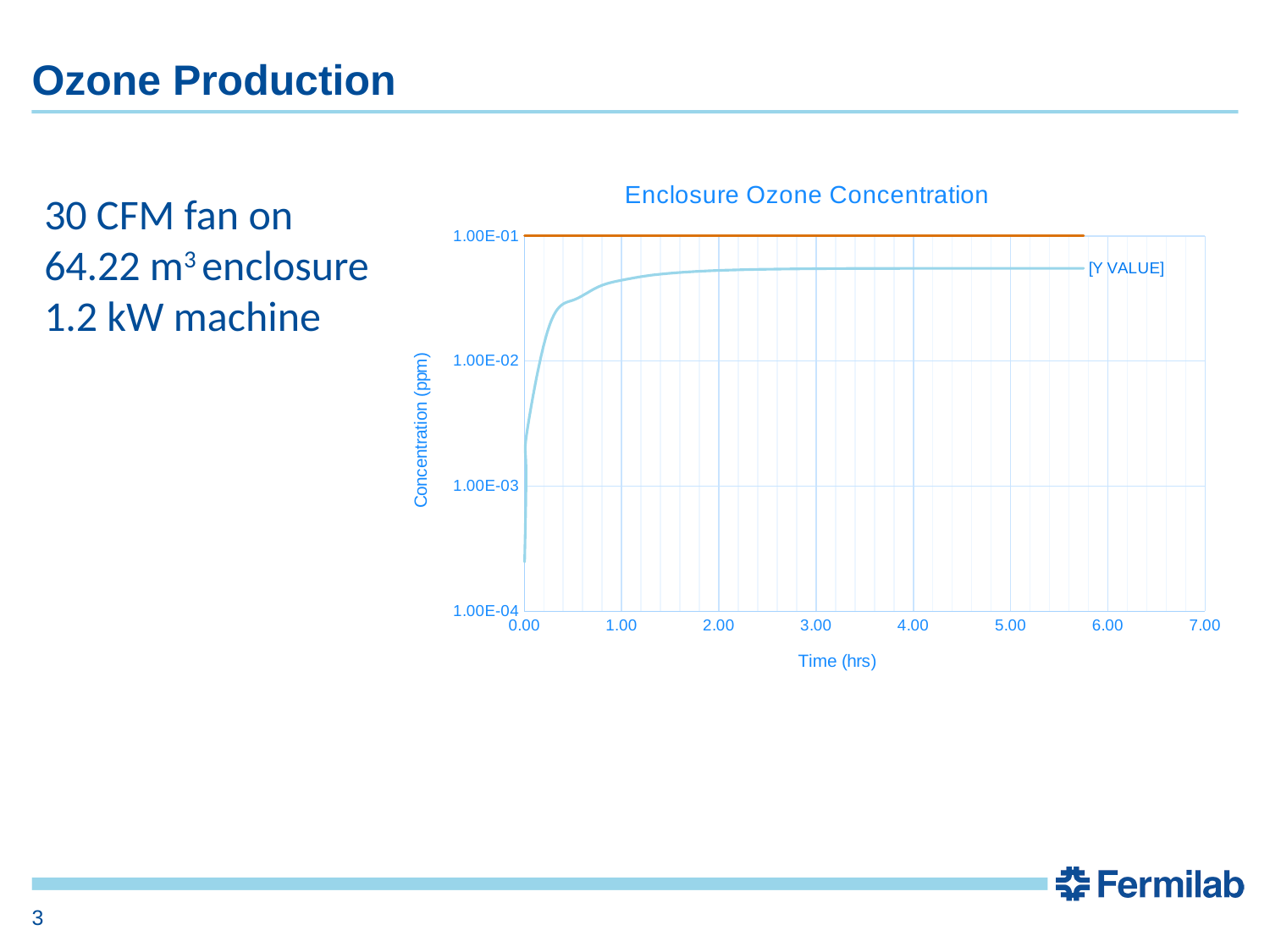
Is the concentration at 1.00 hrs greater or less than 1.00E-02 ppm? greater Is the concentration at 0.00 hrs greater or less than 1.00E-03 ppm? less Which is larger, the concentration at 0.00 hrs or the concentration at 3.00 hrs? 3.00 hrs Is the concentration at 5.00 hrs greater or less than 1.00E-01 ppm? less What kind of chart is shown on the slide? line chart Does the blue concentration line rise or fall as time increases from 0.00 hrs? rise What is the highest value shown on the x axis? 7.00 What is the title of the chart? Enclosure Ozone Concentration At which y-axis value does the orange horizontal line lie? 1.00E-01 What is the label of the x axis of the chart? Time (hrs) What is the lowest value shown on the y axis? 1.00E-04